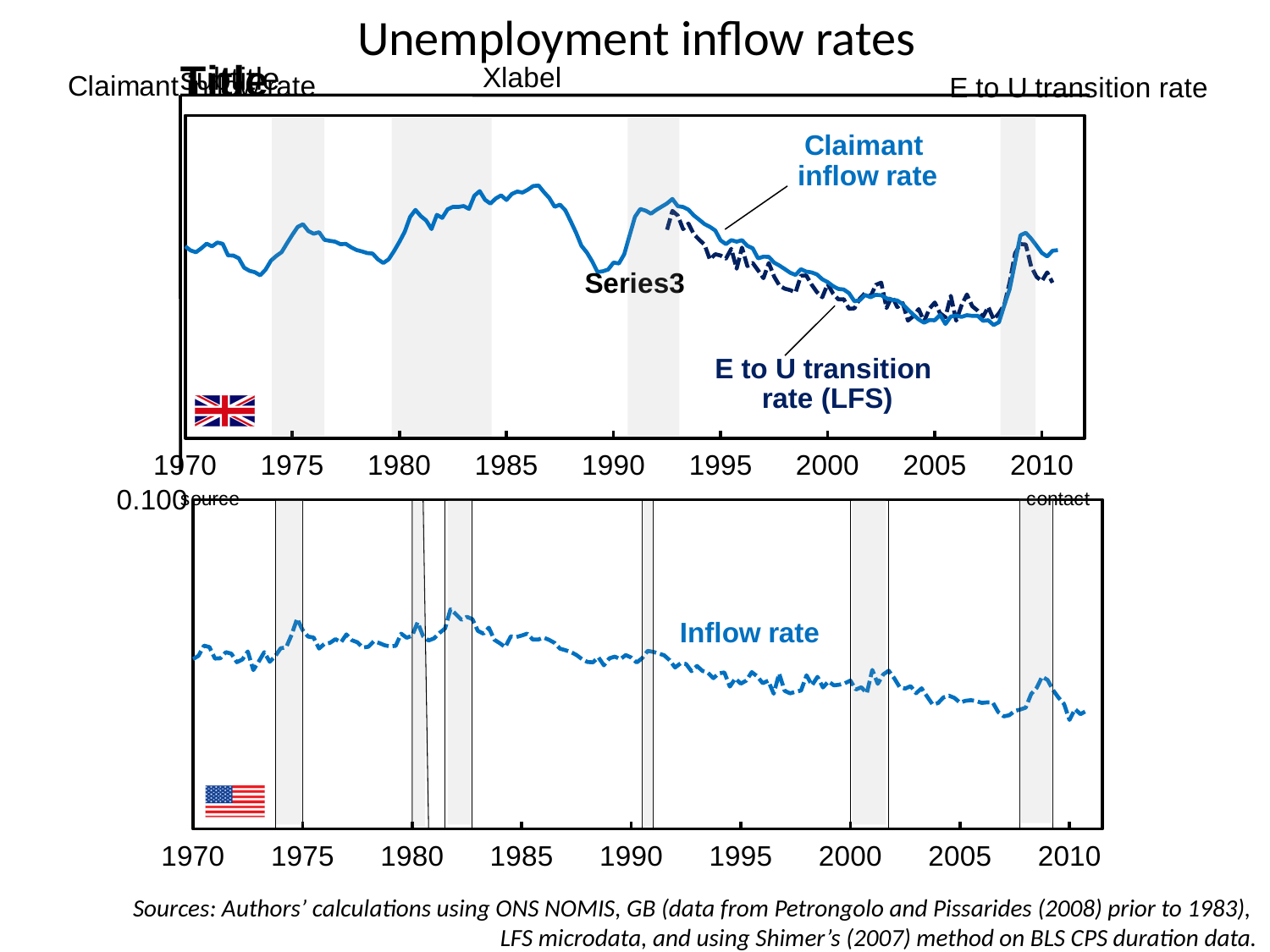
In the bottom chart, what is the name of the plotted series? Inflow rate In the bottom chart, does the Inflow rate generally rise or fall between 1985 and 2007? fall What is the first year label and the last year label shown on the x axis of the bottom chart? 1970 and 2010 What is the title of the slide? Unemployment inflow rates In the top chart, does the Claimant inflow rate rise or fall between 1993 and 2004? fall What kind of chart is the top chart on the slide? line chart In the top chart, what are the names of the two plotted series? Claimant inflow rate; E to U transition rate (LFS) In the top chart, is the Claimant inflow rate higher around 1986 or around 2005? around 1986 In the top chart, how many data series are plotted? 2 In the bottom chart, how many data series are plotted? 1 What kind of chart is the bottom chart on the slide? line chart